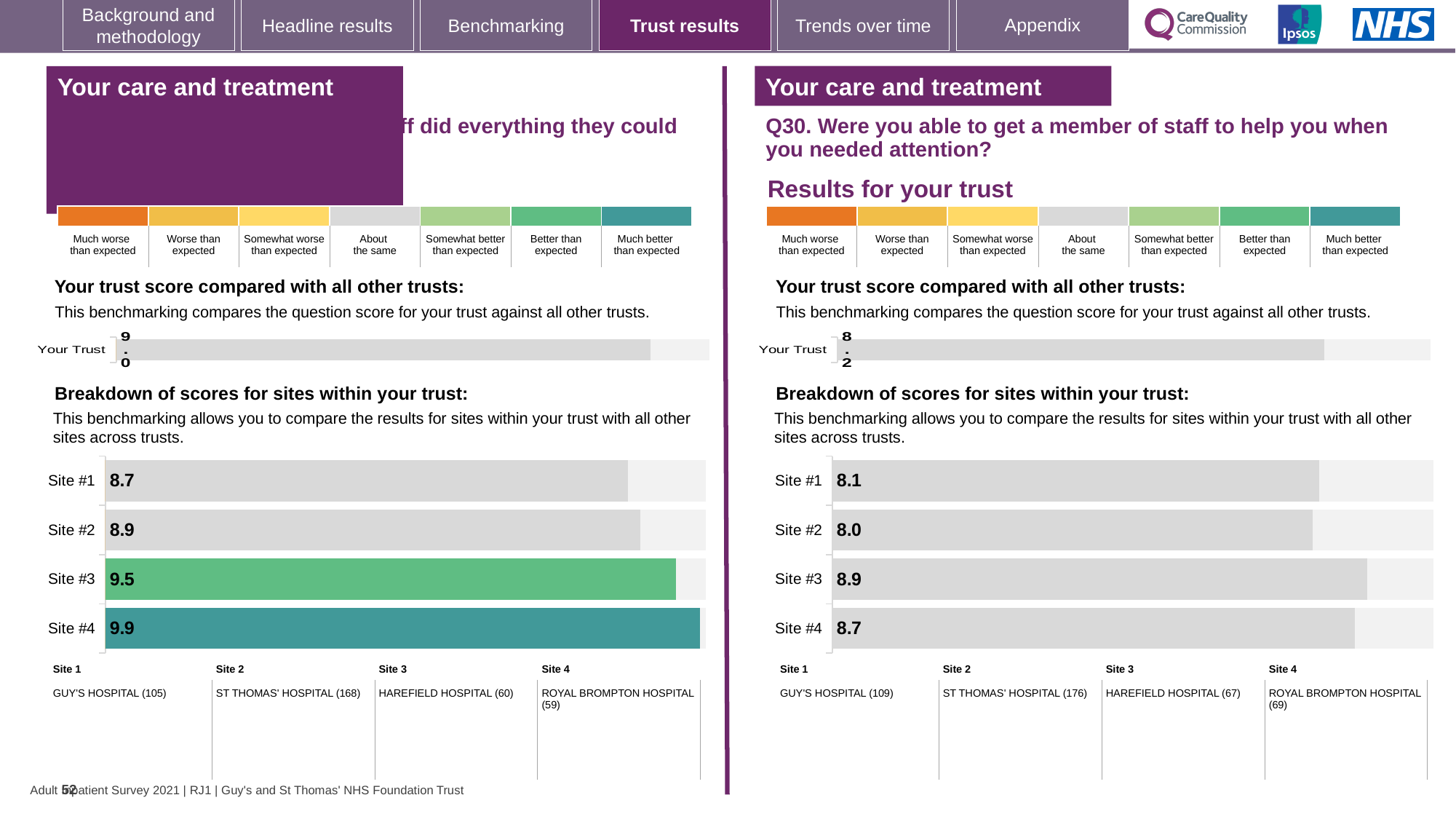
In the left-hand site breakdown chart, what is the score for Site #1? 8.7 In the Q30 site breakdown chart on the right, what is the difference between the scores for Site #3 and Site #2? 0.9 In the Q30 site breakdown chart on the right, which site has the highest score? Site #3 In the Q30 site breakdown chart on the right, which site has the lowest score? Site #2 In the left-hand site breakdown chart, which site has the highest score? Site #4 In the left-hand site breakdown chart, which has the higher score, Site #2 or Site #3? Site #3 In the left-hand site breakdown chart, what is the difference between the scores for Site #4 and Site #1? 1.2 In the Q30 site breakdown chart on the right, what is the score for Site #3? 8.9 What type of chart is used for the breakdown of scores for sites within the trust? Bar chart How many sites are shown in the Q30 site breakdown chart on the right? 4 In the Q30 site breakdown chart on the right, what is the score for Site #2? 8.0 In the left-hand site breakdown chart, what is the score for Site #4? 9.9